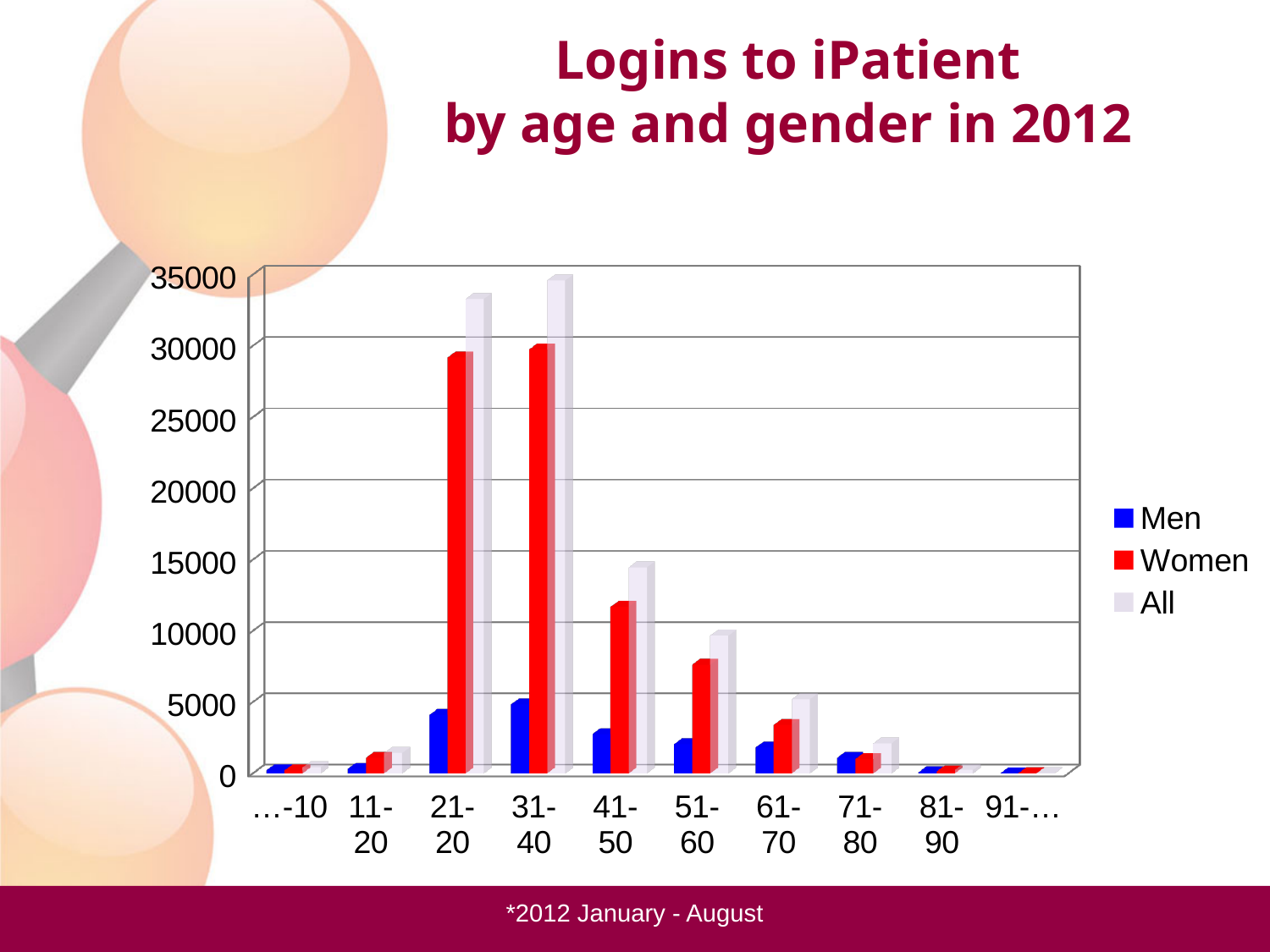
Which age category has the highest value for the All series? 31-40 How many series does the legend list? 3 Which age category has the highest value for the Men series? 31-40 From the 31-40 age group onward, do the values for the All series rise or fall along the x axis? fall Is the value for All in the 51-60 age group greater or less than 5000? greater How many age categories are shown on the x axis? 10 In the 31-40 age group, which is larger, the value for Men or the value for Women? Women Is the value for Women in the 41-50 age group greater or less than 10000? greater Is the value for All in the 21-20 age group greater or less than 30000? greater Which colour represents the Women series in the legend? red What kind of chart is shown on the slide? bar chart